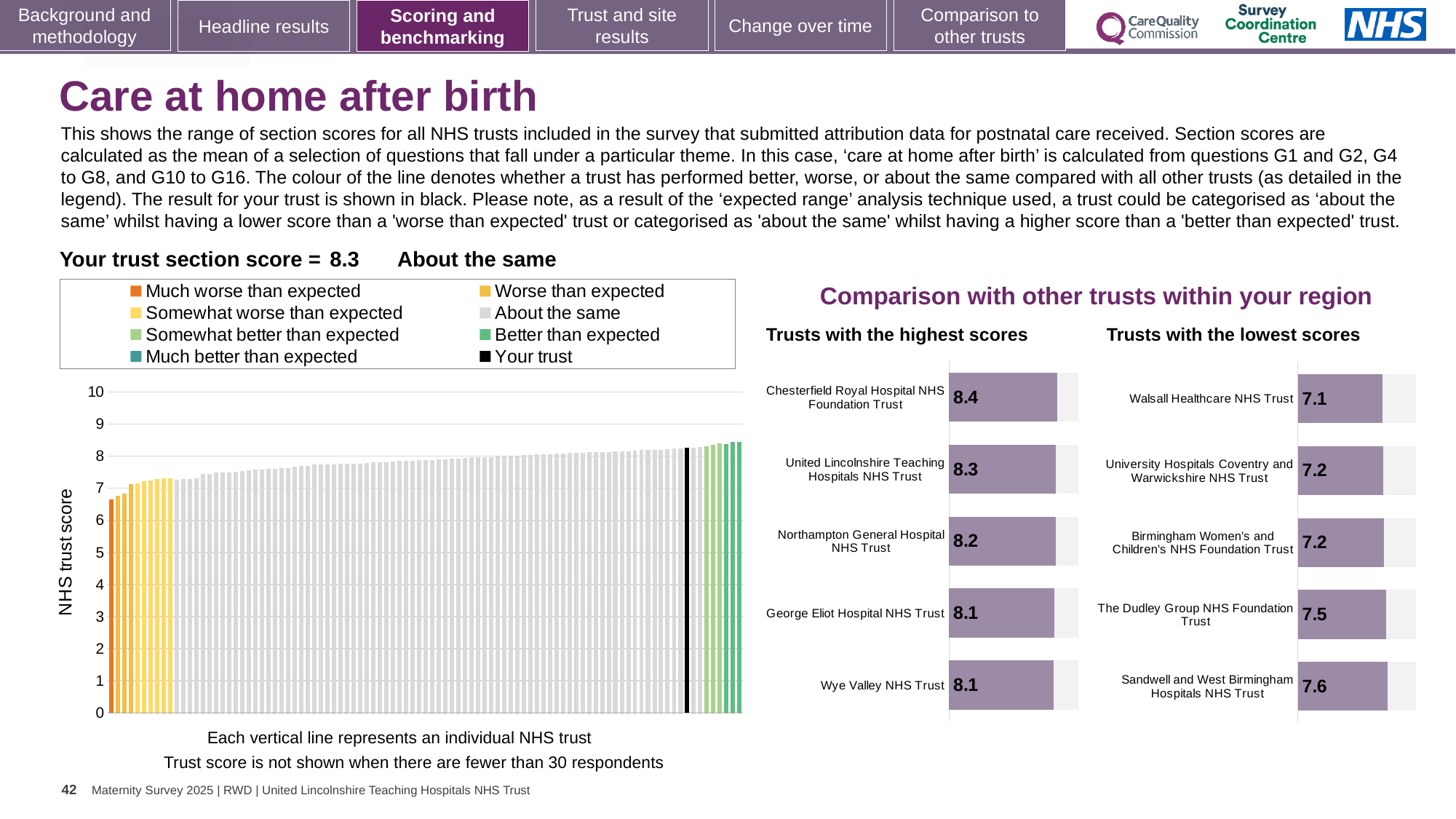
How many entries does the legend of the NHS trust score chart on the left list? 8 In the NHS trust score chart on the left, what colour is used for 'Your trust' according to the legend? Black In the 'Trusts with the lowest scores' chart, which has the larger score: The Dudley Group NHS Foundation Trust or Sandwell and West Birmingham Hospitals NHS Trust? Sandwell and West Birmingham Hospitals NHS Trust In the 'Trusts with the lowest scores' chart, which trust has the lowest score? Walsall Healthcare NHS Trust How many trusts are shown in the 'Trusts with the highest scores' chart? 5 What kind of chart is the NHS trust score chart on the left of the slide? Bar chart In the 'Trusts with the highest scores' chart, what is the score for Chesterfield Royal Hospital NHS Foundation Trust? 8.4 In the 'Trusts with the lowest scores' chart, what is the score for Walsall Healthcare NHS Trust? 7.1 In the NHS trust score chart on the left, do the values rise or fall from left to right? Rise In the 'Trusts with the highest scores' chart, what is the difference between the scores of Chesterfield Royal Hospital NHS Foundation Trust and Wye Valley NHS Trust? 0.3 In the 'Trusts with the lowest scores' chart, what is the score for Sandwell and West Birmingham Hospitals NHS Trust? 7.6 In the 'Trusts with the highest scores' chart, which trust has the highest score? Chesterfield Royal Hospital NHS Foundation Trust